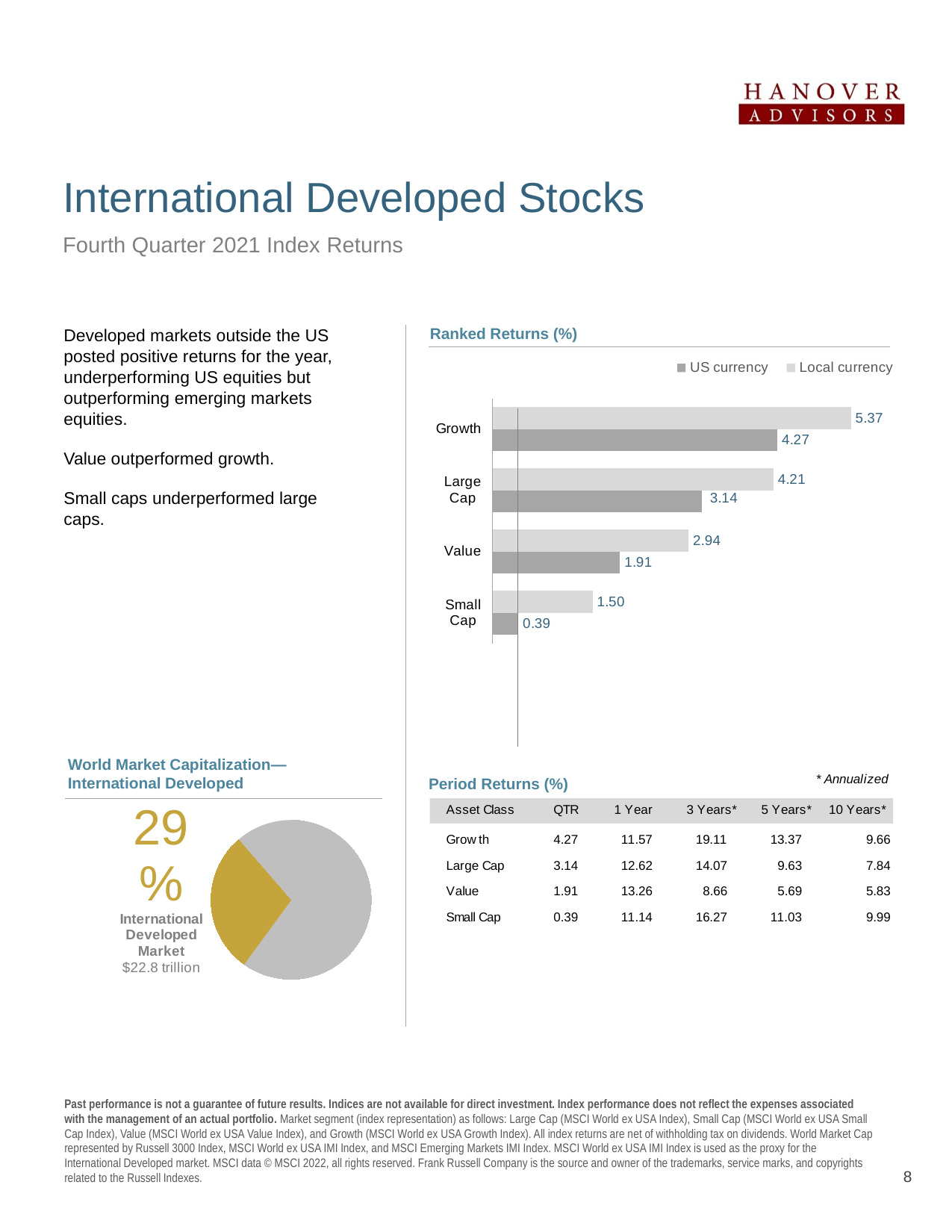
What type of chart is the World Market Capitalization—International Developed chart? Pie chart In the Ranked Returns (%) chart, what is the US currency return for Growth? 4.27 How many categories are shown in the Ranked Returns (%) chart? 4 In the Ranked Returns (%) chart, what is the difference between the Local currency and US currency returns for Value? 1.03 In the Ranked Returns (%) chart, which is larger: the US currency return for Large Cap or the Local currency return for Value? US currency return for Large Cap What type of chart is the Ranked Returns (%) chart? Bar chart In the Ranked Returns (%) chart, what is the Local currency return for Small Cap? 1.50 In the World Market Capitalization—International Developed pie chart, what share does the International Developed Market slice represent? 29% In the Ranked Returns (%) chart, which category has the highest US currency return? Growth In the Ranked Returns (%) chart, which category has the lowest Local currency return? Small Cap How many series does the legend of the Ranked Returns (%) chart list? 2 In the Ranked Returns (%) chart, what is the Local currency return for Large Cap? 4.21